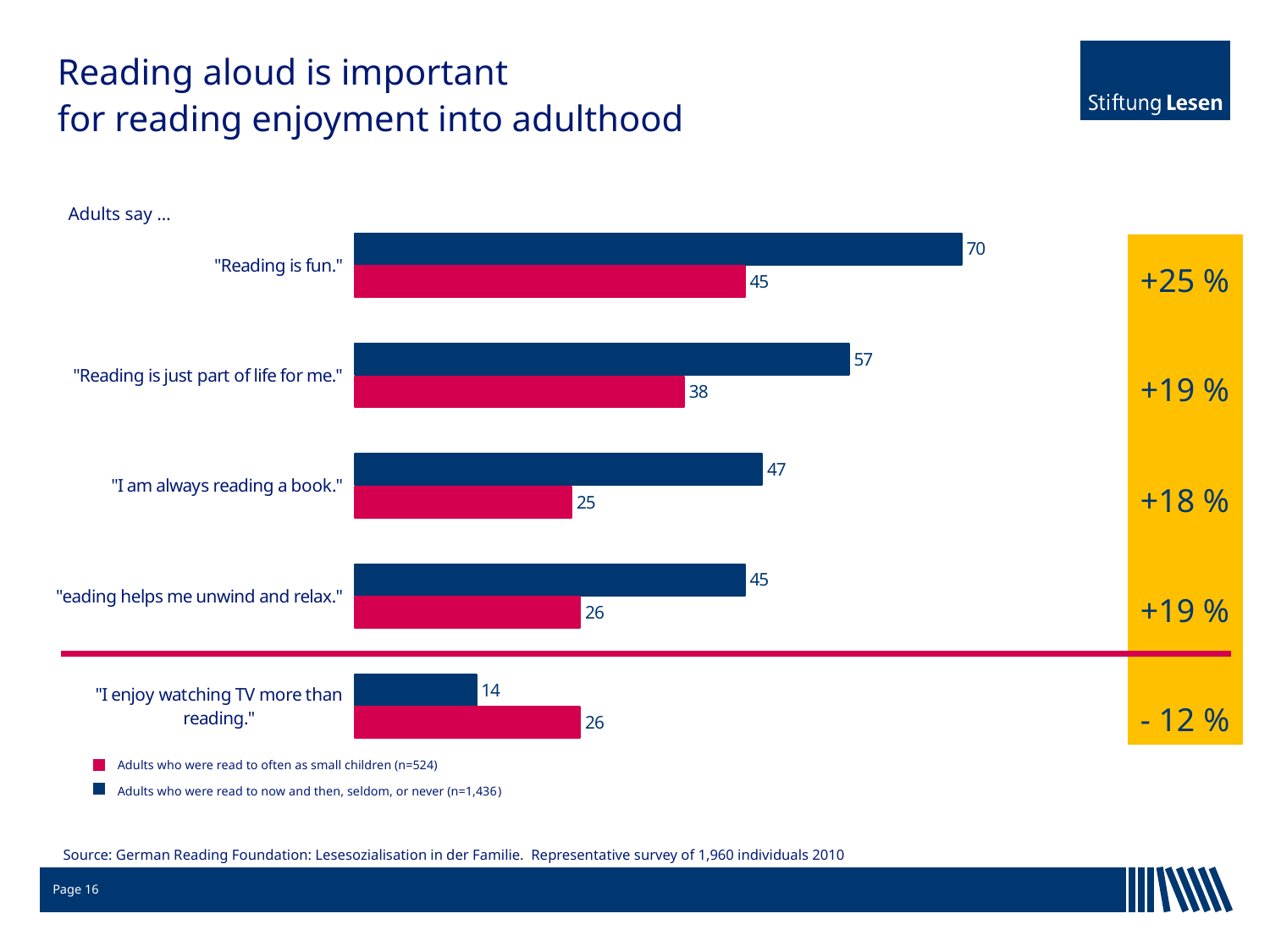
What is the difference between the dark blue bar and the red bar for "I am always reading a book."? 22 How many series does the legend list? 2 What is the value of the dark blue bar for "Reading is fun."? 70 What kind of chart is shown on the slide? bar chart For "I enjoy watching TV more than reading.", which bar is larger, the dark blue bar or the red bar? the red bar What is the value of the red bar for "I am always reading a book."? 25 How many statements are shown in the chart? 5 What is the value of the red bar for "Reading is fun."? 45 Which statement has the highest dark blue bar value? "Reading is fun." Which statement has the lowest dark blue bar value? "I enjoy watching TV more than reading." What is the value of the dark blue bar for "I enjoy watching TV more than reading."? 14 What is the value of the dark blue bar for "Reading is just part of life for me."? 57